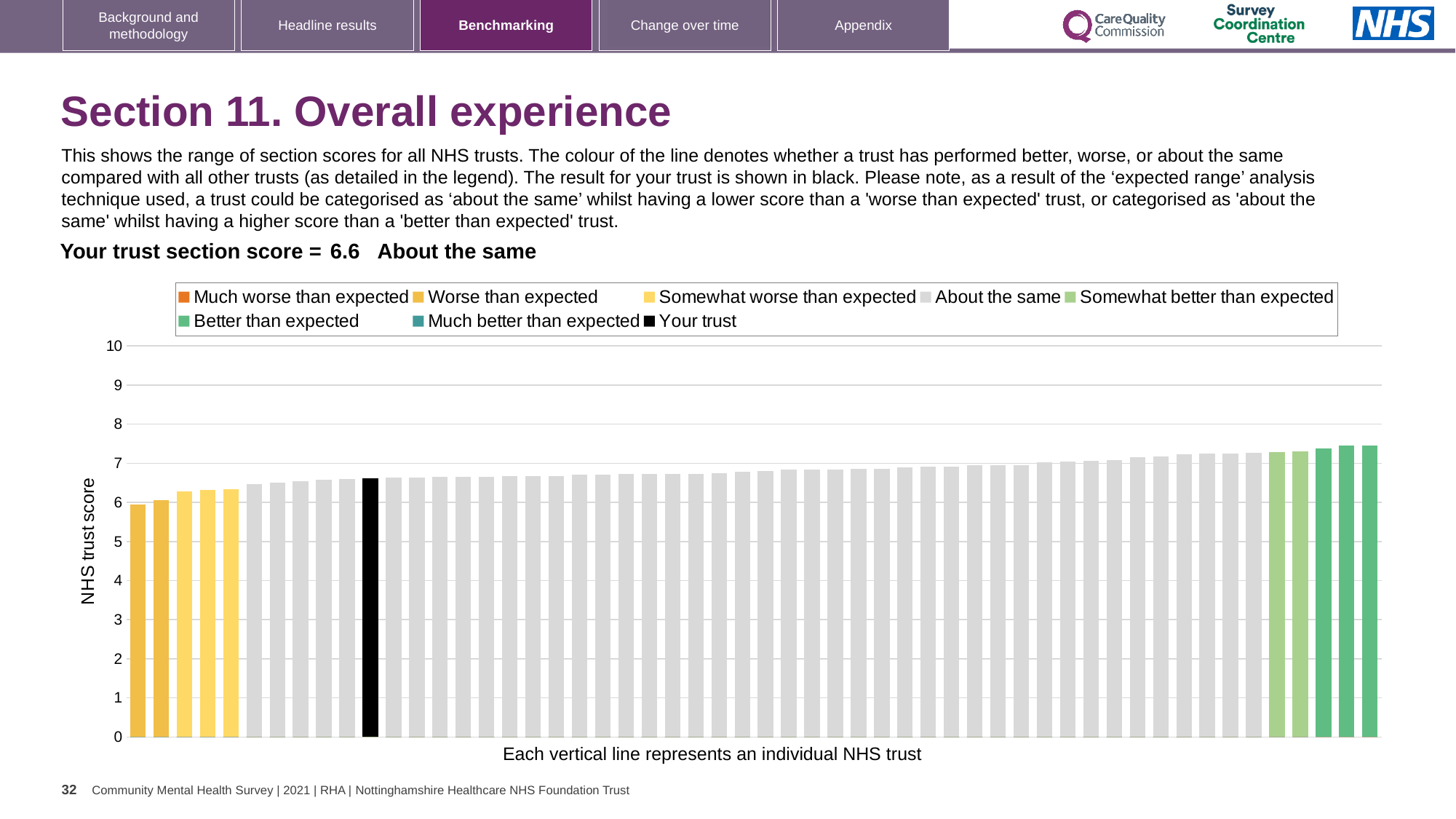
What is the label on the vertical axis of the chart? NHS trust score How many entries does the chart legend list? 8 What kind of chart is shown on the slide? Bar chart Which performance category is your trust placed in for this section? About the same Which is larger: the value of the black 'Your trust' bar or the value of the rightmost green bar? The rightmost green bar Is the value of the leftmost (lowest) bar greater or less than 5? greater How many bars are coloured in the 'Worse than expected' (darker yellow) colour? 2 What is the section score for your trust shown on the slide? 6.6 Is the value of the black bar (your trust) greater or less than 5? greater How many bars are coloured in the 'Better than expected' (darker green) colour? 3 Do the bar values rise or fall from left to right along the x axis? Rise Is the value of the tallest bar greater or less than 8? less